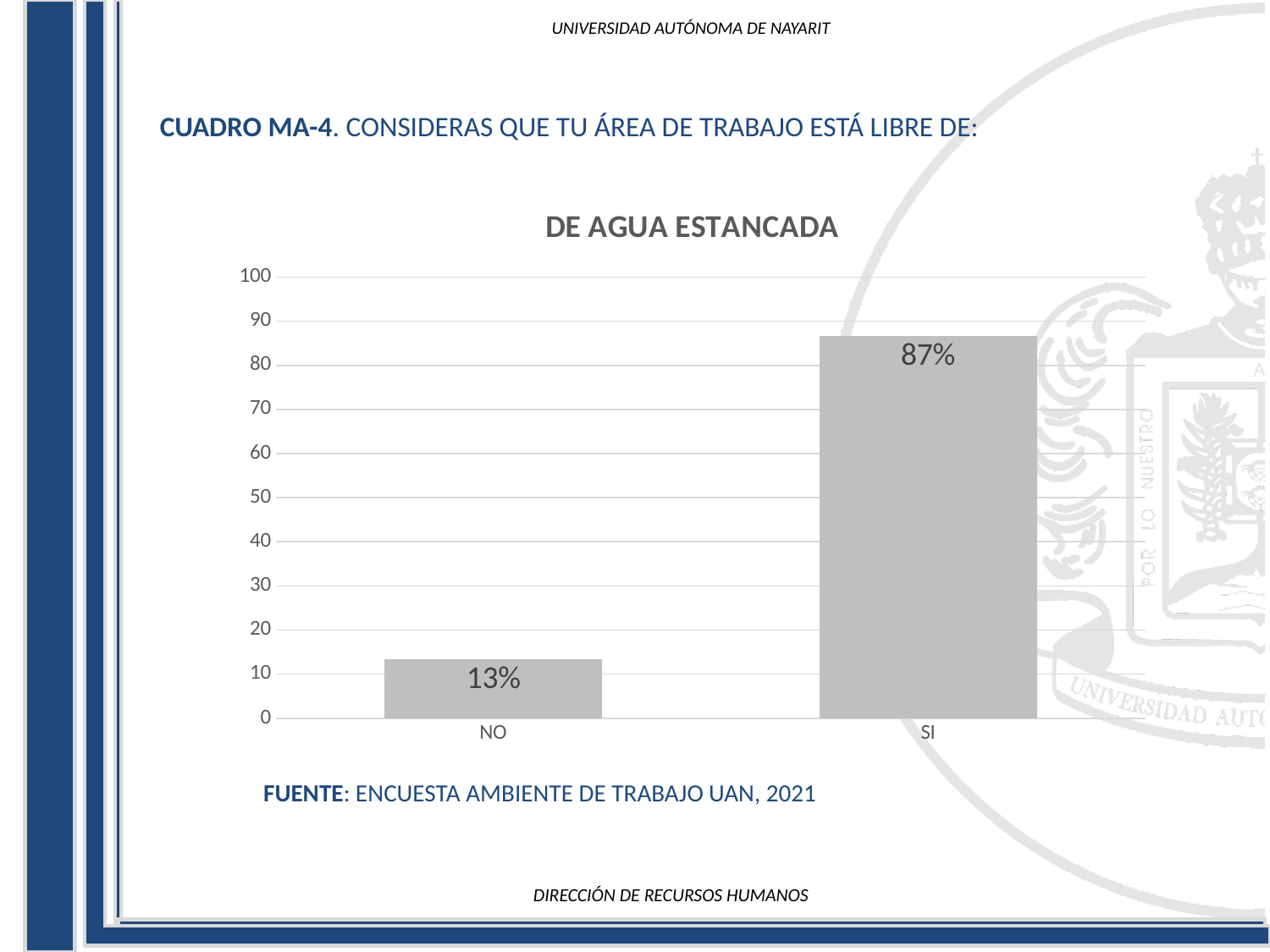
Is the value for NO greater or less than 20? less What is the difference between the values for SI and NO? 74% What kind of chart is shown? bar chart Is the value for SI greater or less than 80? greater What is the title of the chart? DE AGUA ESTANCADA Which category has the highest value? SI What is the highest value shown on the y axis? 100 Which is larger, the value for NO or the value for SI? SI How many categories are shown on the x axis? 2 What is the value for SI? 87% What is the value for NO? 13% Which category has the lowest value? NO